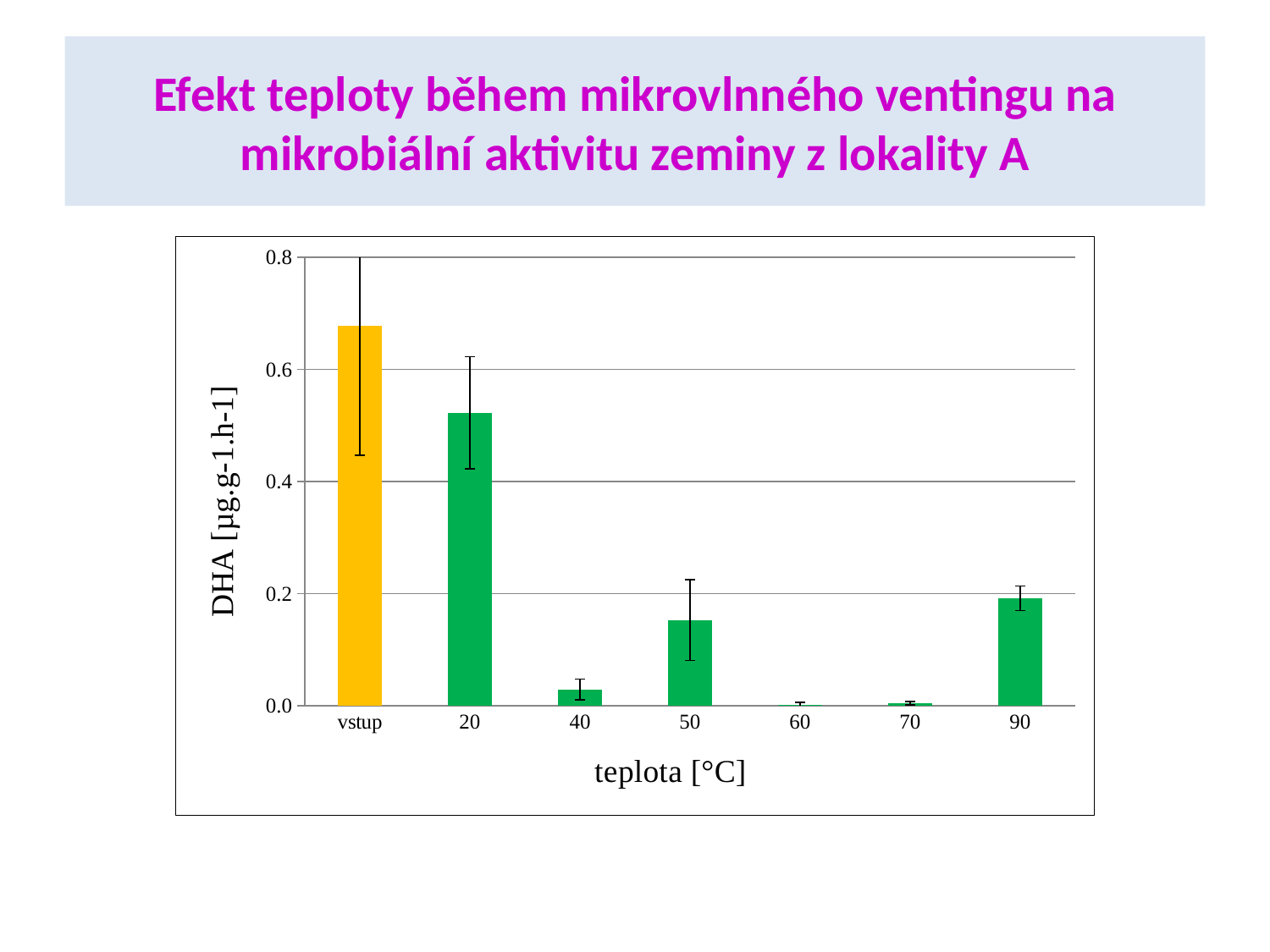
What kind of chart is shown on the slide? bar chart Is the DHA value for 20 °C greater or less than 0.6? less Do the DHA values rise or fall from 20 °C to 60 °C? fall Which category has the highest DHA value? vstup How many categories are shown on the x axis of the chart? 7 Which has a higher DHA value, 20 °C or 90 °C? 20 °C Is the DHA value for vstup greater or less than 0.6? greater Is the DHA value for 20 °C greater or less than 0.4? greater What is the label of the x axis of the chart? teplota [°C] Which has a higher DHA value, vstup or 20 °C? vstup